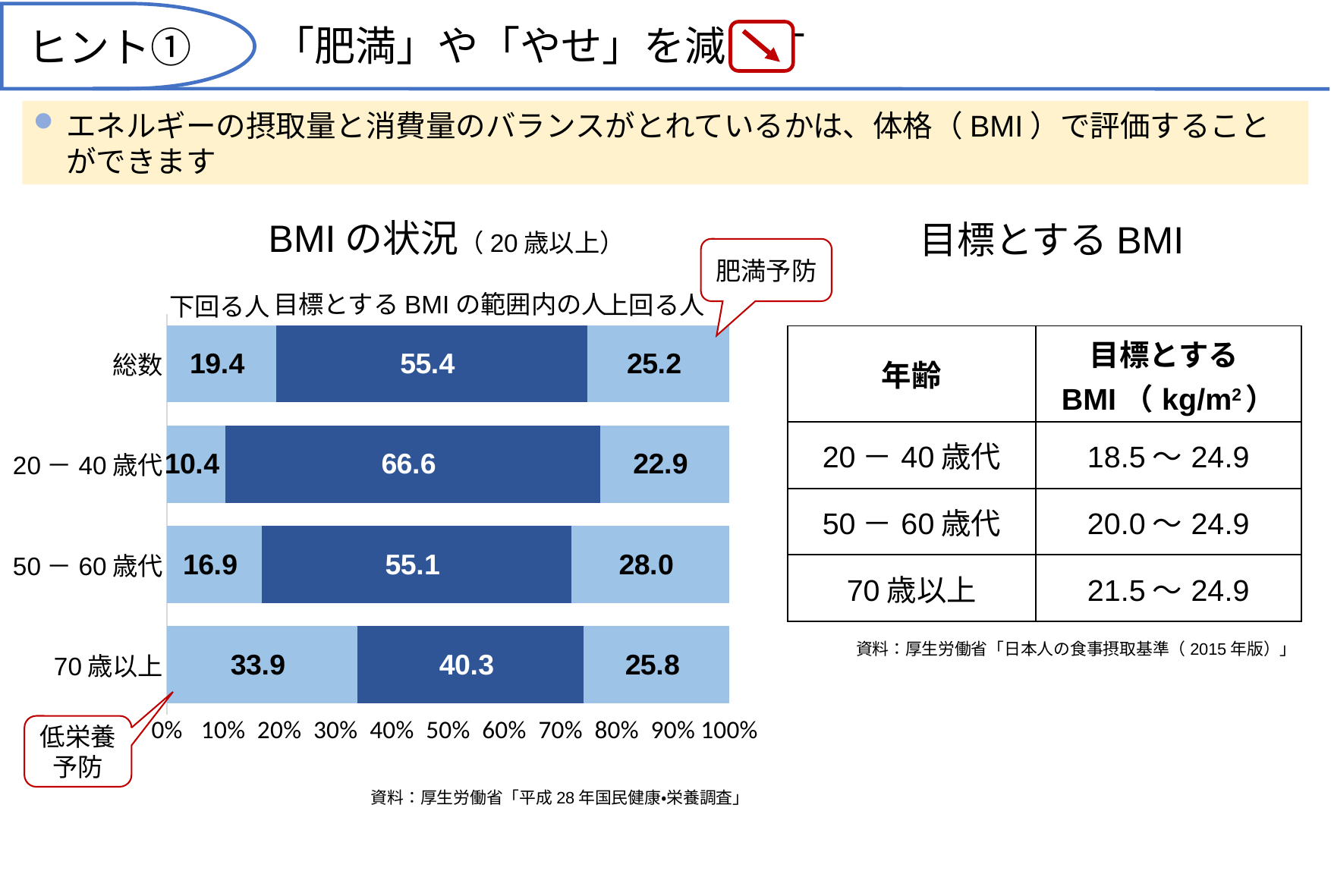
In the chart 'BMIの状況（20歳以上）', which is larger: the 上回る人 value for 50－60歳代 or for 20－40歳代? 50－60歳代 In the chart 'BMIの状況（20歳以上）', how many series does the legend list? 3 In the chart 'BMIの状況（20歳以上）', what is the value for 上回る人 in the 50－60歳代 bar? 28.0 In the chart 'BMIの状況（20歳以上）', which age group has the highest value for 下回る人? 70歳以上 What kind of chart is 'BMIの状況（20歳以上）'? Stacked bar chart In the chart 'BMIの状況（20歳以上）', which age group has the lowest value for 上回る人? 20－40歳代 In the chart 'BMIの状況（20歳以上）', what is the total of the three segments in the 70歳以上 bar? 100.0 In the chart 'BMIの状況（20歳以上）', what is the name of the middle (dark blue) series in the legend? 目標とするBMIの範囲内の人 In the chart 'BMIの状況（20歳以上）', how many age-group categories are plotted? 4 In the chart 'BMIの状況（20歳以上）', what is the value for 下回る人 in the 総数 bar? 19.4 In the chart 'BMIの状況（20歳以上）', what is the difference between the 下回る人 values for 70歳以上 and 総数? 14.5 In the chart 'BMIの状況（20歳以上）', what is the value for 目標とするBMIの範囲内の人 in the 20－40歳代 bar? 66.6